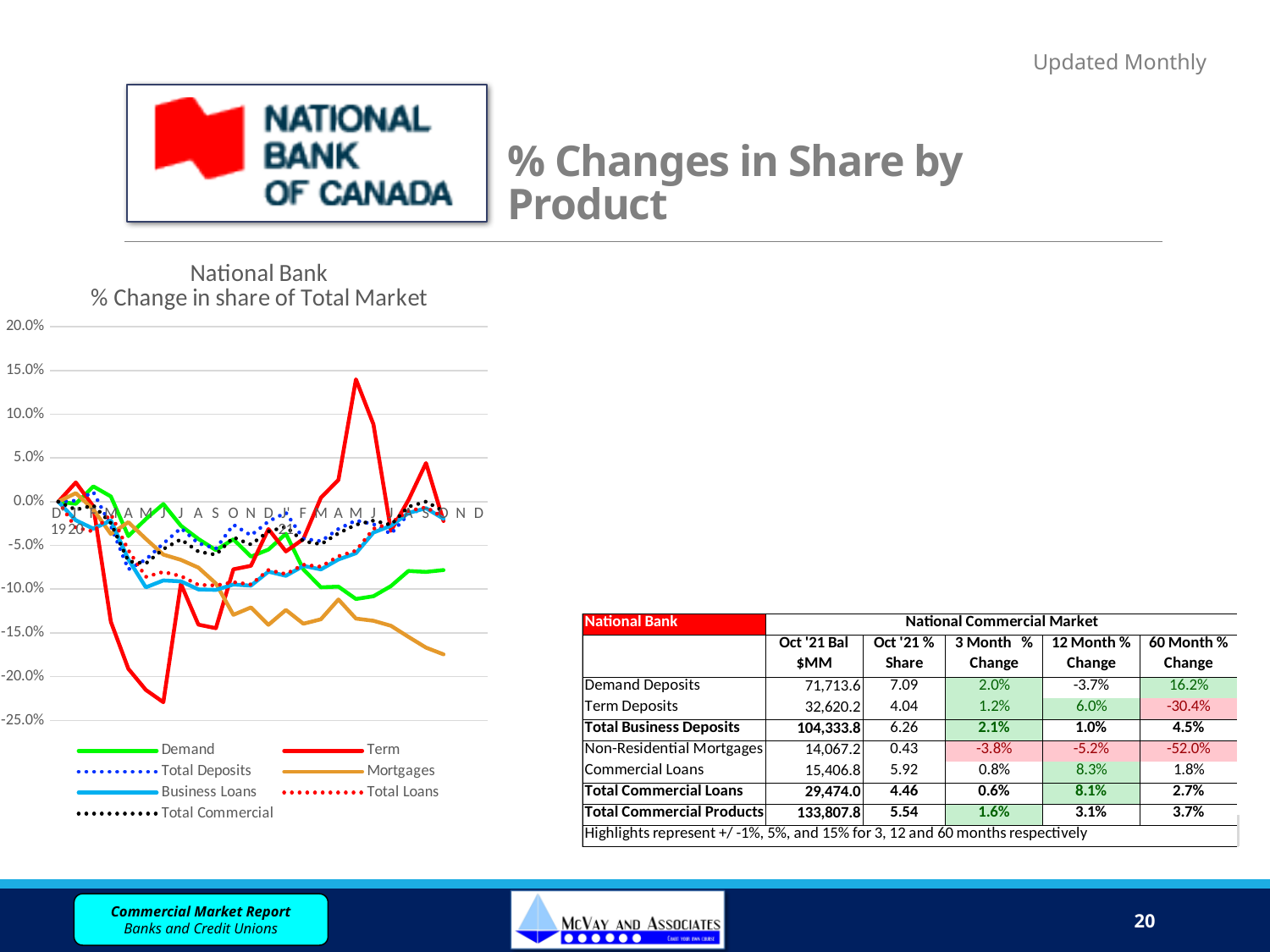
Is the lowest value of the Term series greater or less than -20.0%? less Which series is drawn in green on the line chart? Demand How many series does the legend of the line chart list? 7 Which series reaches the lowest value anywhere on the line chart? Term Which series ends at the lowest value at the final point of the line chart? Mortgages Is the final value of the Mortgages series greater or less than -15.0%? less Which series reaches the highest value anywhere on the line chart? Term Is the peak value of the Term series greater or less than 10.0%? greater What is the title of the line chart? National Bank % Change in share of Total Market At the last point on the x axis, which series is higher: Demand or Mortgages? Demand What kind of chart is shown on the slide? Line chart